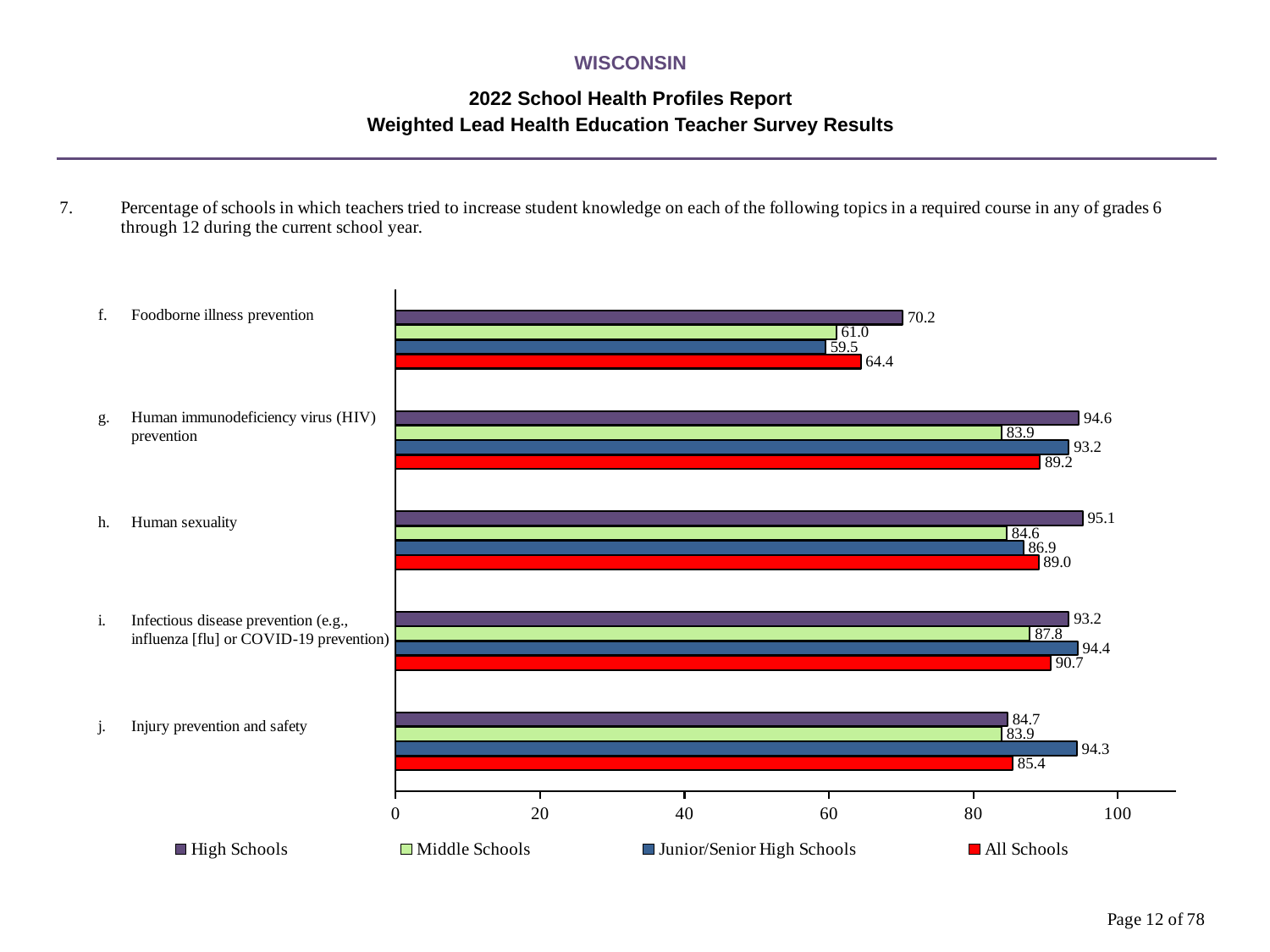
What is the value for All Schools for Human sexuality? 89.0 How many series does the legend list? 4 Which is larger for Injury prevention and safety: the High Schools value or the Junior/Senior High Schools value? Junior/Senior High Schools How many topics are shown on the chart? 5 Which topic has the highest value for High Schools? Human sexuality What is the value for High Schools for Foodborne illness prevention? 70.2 What is the difference between the High Schools and Middle Schools values for Foodborne illness prevention? 9.2 What is the value for Junior/Senior High Schools for Injury prevention and safety? 94.3 What is the value for Middle Schools for Infectious disease prevention? 87.8 Is the value for Junior/Senior High Schools for Foodborne illness prevention greater or less than 60? less What kind of chart is shown on the slide? bar chart Which topic has the lowest value for All Schools? Foodborne illness prevention